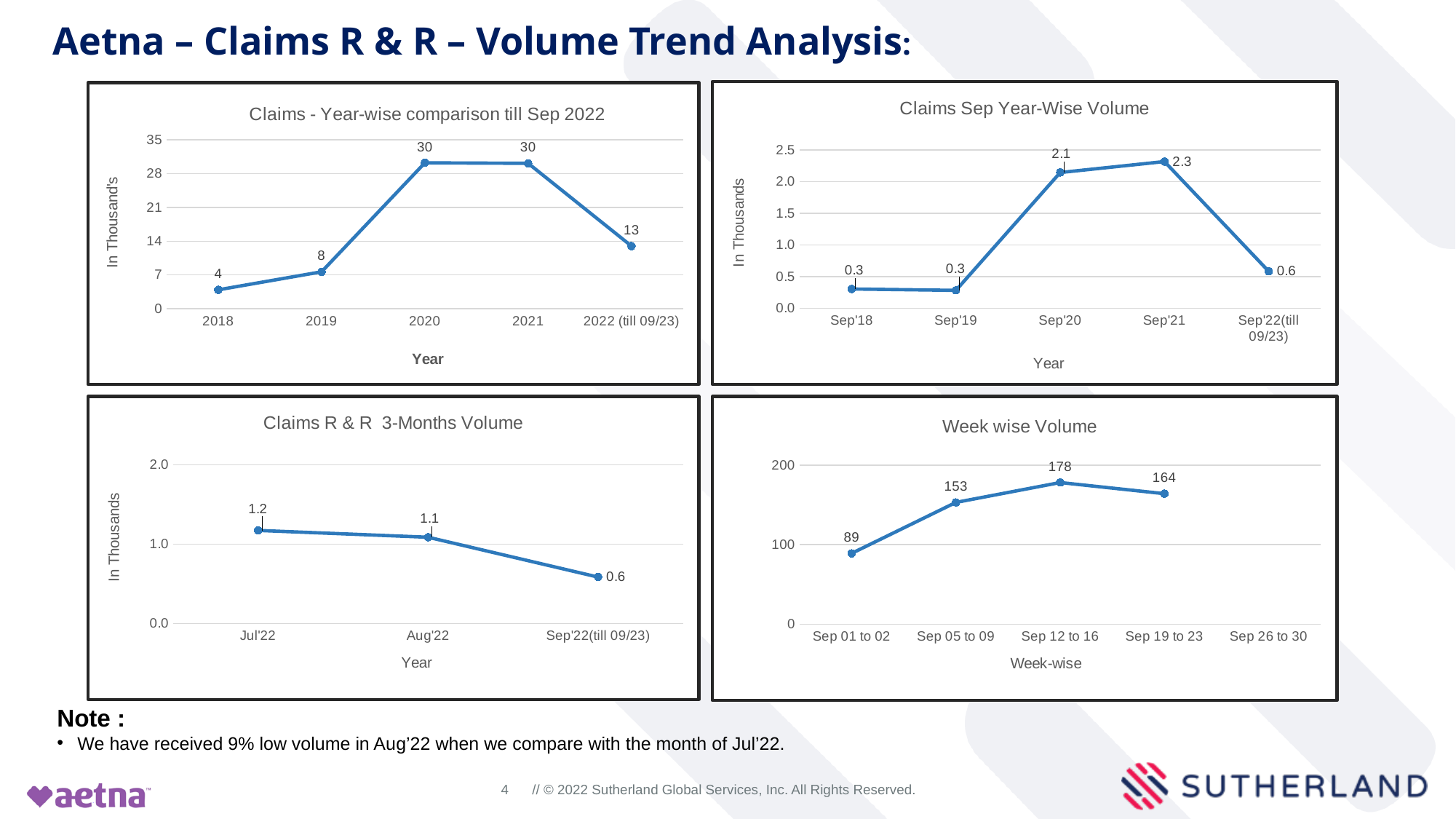
In the 'Claims Sep Year-Wise Volume' chart, how many data points are plotted? 5 In the 'Claims - Year-wise comparison till Sep 2022' chart, what is the value for 2022 (till 09/23)? 13 In the 'Claims R & R 3-Months Volume' chart, do the values rise or fall from Jul'22 to Sep'22(till 09/23)? fall In the 'Week wise Volume' chart, what is the difference between the values for Sep 12 to 16 and Sep 19 to 23? 14 In the 'Claims R & R 3-Months Volume' chart, what is the value for Aug'22? 1.1 In the 'Claims Sep Year-Wise Volume' chart, what is the value for Sep'20? 2.1 In the 'Week wise Volume' chart, what is the value for Sep 01 to 02? 89 In the 'Claims - Year-wise comparison till Sep 2022' chart, what is the value for 2019? 8 In the 'Week wise Volume' chart, which week has the highest value? Sep 12 to 16 In the 'Claims - Year-wise comparison till Sep 2022' chart, what is the difference between the values for 2021 and 2022 (till 09/23)? 17 In the 'Claims Sep Year-Wise Volume' chart, which year has the highest value? Sep'21 What type of chart is the 'Week wise Volume' chart? line chart